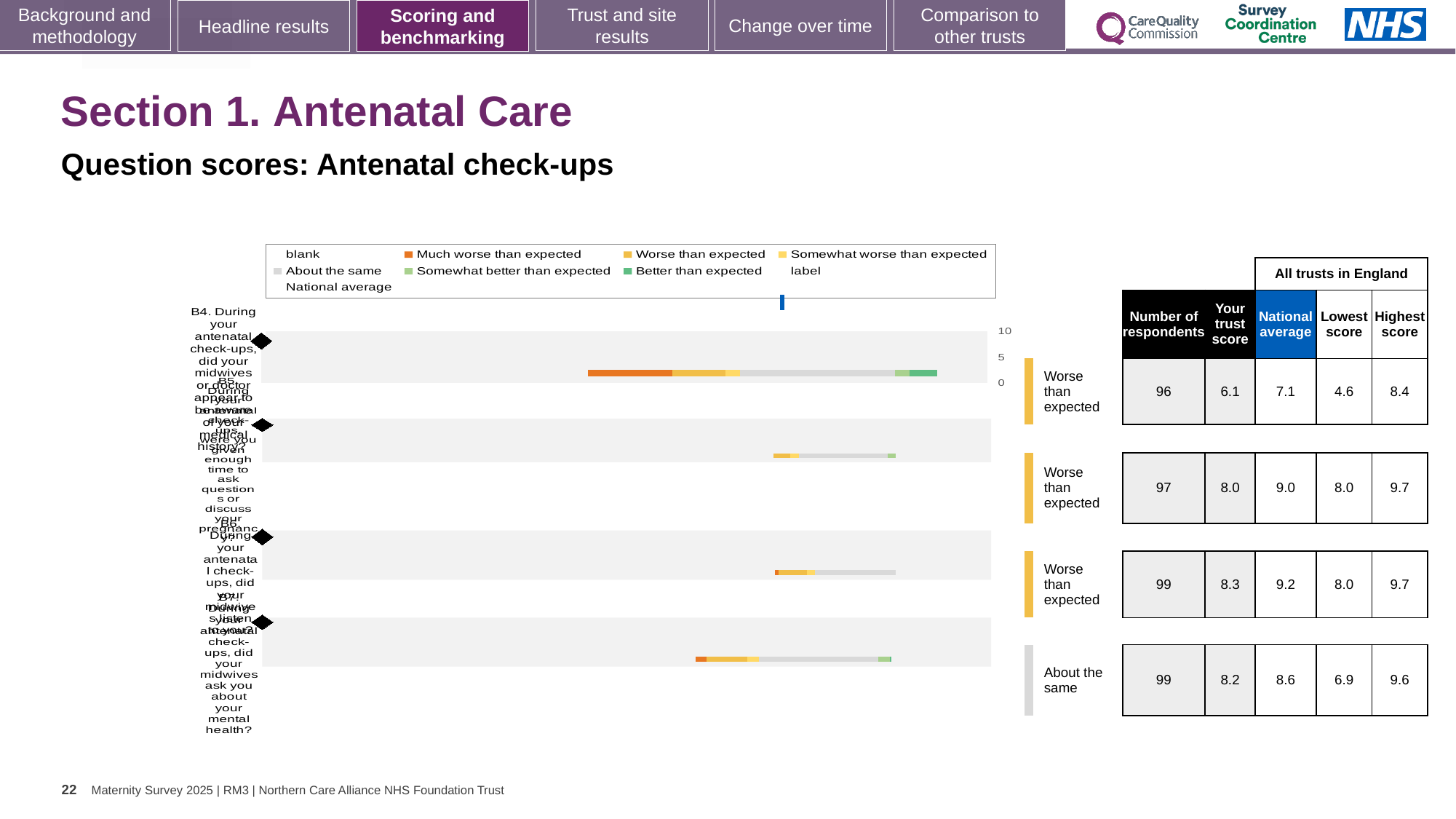
What is the national average for the first question row (B4)? 7.1 In the chart legend, what colour represents 'Better than expected'? green In the chart legend, what colour represents 'Much worse than expected'? orange What benchmark label is given to the last question row (B7)? About the same What is the difference between the national average and the trust score for the first question row (B4)? 1.0 What is the highest score across all trusts in England for the last question row (B7)? 9.6 What kind of chart is shown on the slide? bar chart What is the number of respondents for the last question row (B7, about mental health)? 99 How many question rows (bars) does the chart show? 4 What is the 'Your trust score' for the first question row (B4)? 6.1 Which question row has the lowest 'Your trust score'? B4 (first row), 6.1 Which question row has the highest 'Your trust score'? B6 (third row), 8.3